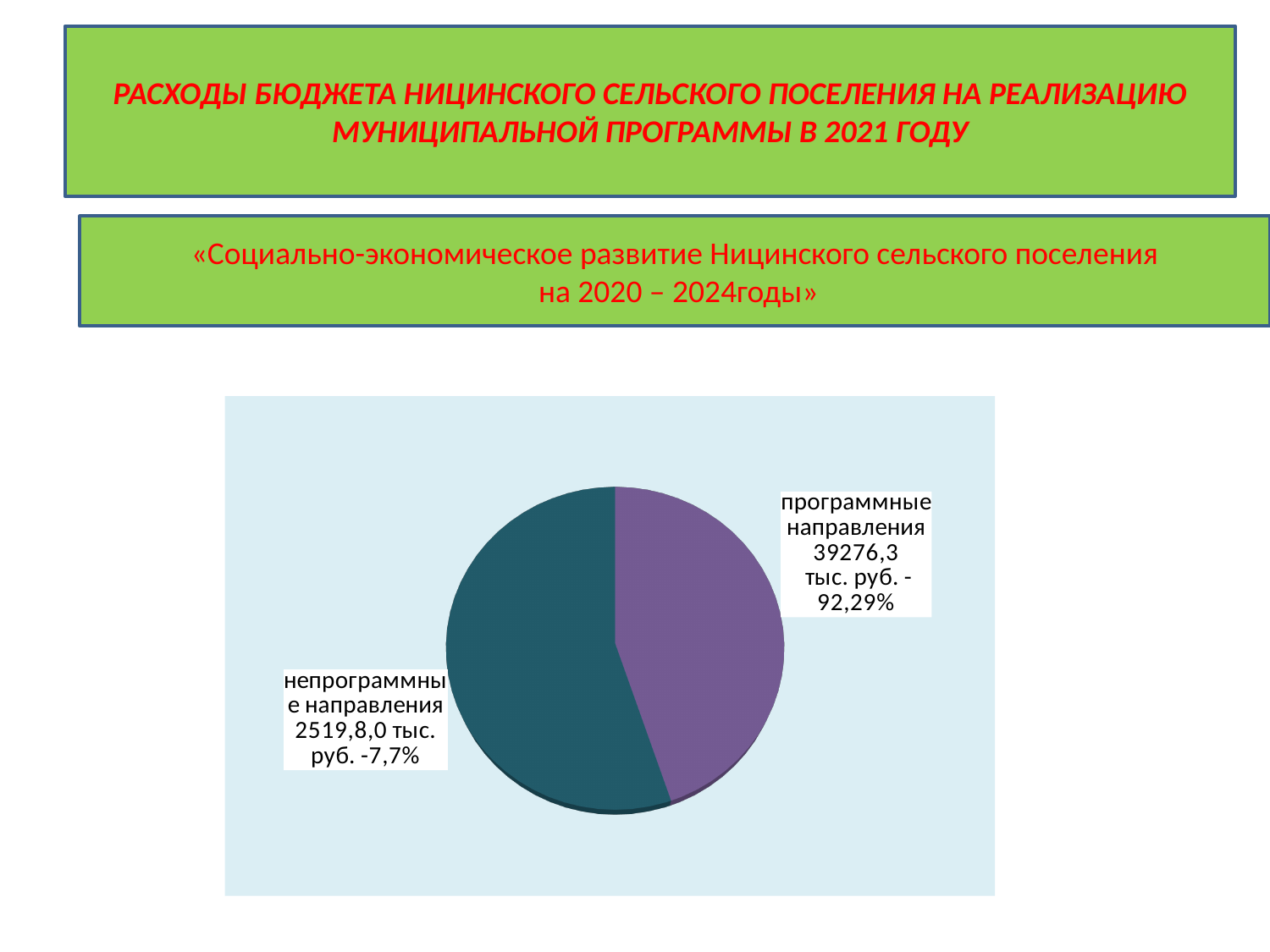
What colour is the slice for непрограммные направления? dark teal What amount is shown for непрограммные направления in the pie chart? 2519,8,0 тыс. руб. What kind of chart is shown on the slide? pie chart What share of the pie is labelled for непрограммные направления? 7,7% What amount is shown for программные направления in the pie chart? 39276,3 тыс. руб. What colour is the slice for программные направления? purple What share of the pie is labelled for программные направления? 92,29% How many slices does the pie chart have? 2